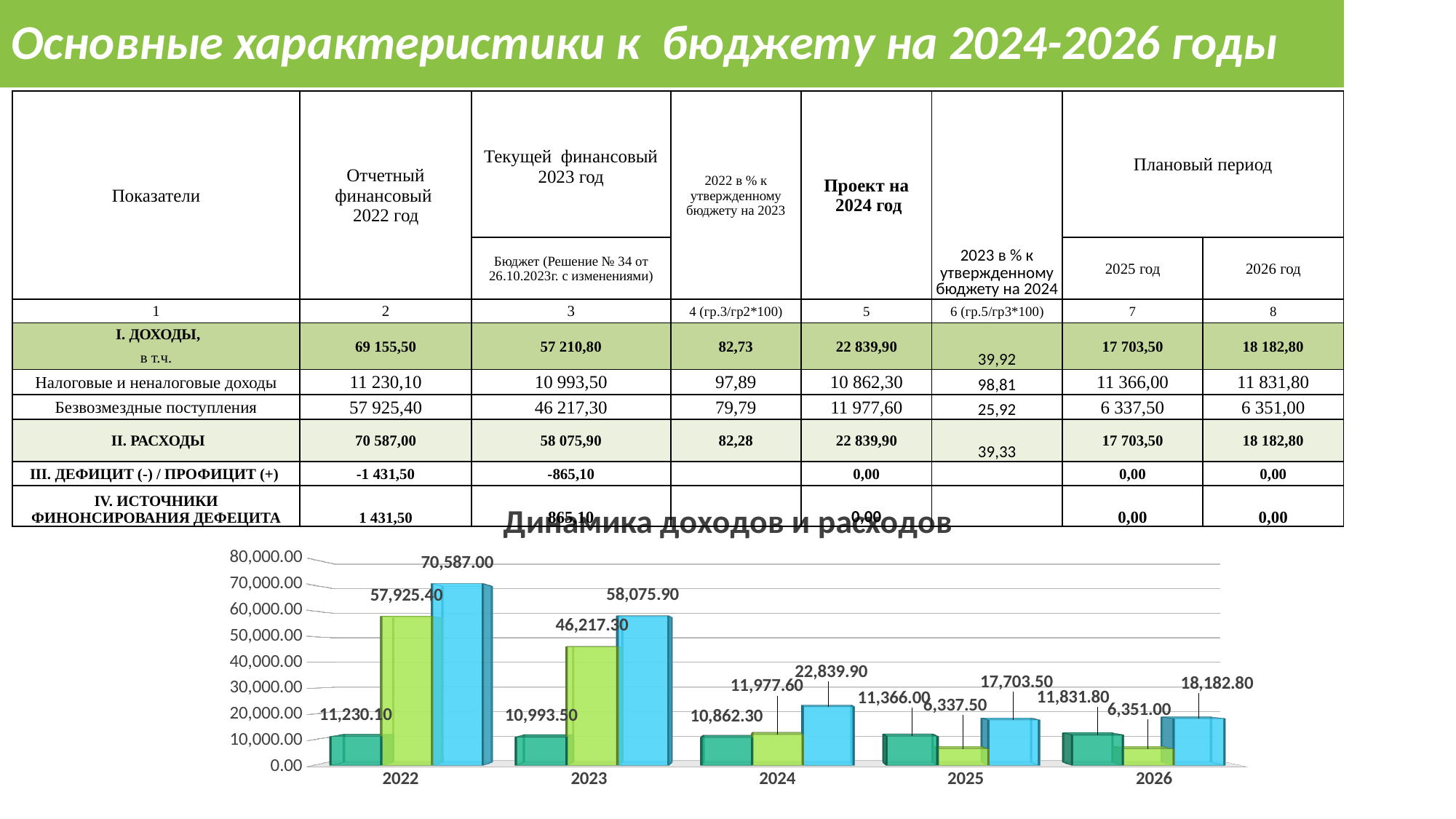
Which year has the highest blue bar in the chart? 2022 What is the value of the blue bar for 2026 in the chart? 18,182.80 What type of chart is shown under the title 'Динамика доходов и расходов'? bar chart What is the title of the chart on the slide? Динамика доходов и расходов How many year categories are shown on the x axis of the chart? 5 Which is larger in the chart: the light green bar for 2024 or the light green bar for 2025? 2024 What is the difference between the blue bar values for 2022 and 2023 in the chart? 12,511.10 What is the value of the dark green bar for 2024 in the chart? 10,862.30 Which year has the lowest light green bar in the chart? 2025 What is the value of the light green bar for 2023 in the chart? 46,217.30 Do the blue bar values rise or fall from 2022 to 2024 in the chart? fall What is the value of the tallest (blue) bar for 2022 in the chart? 70,587.00